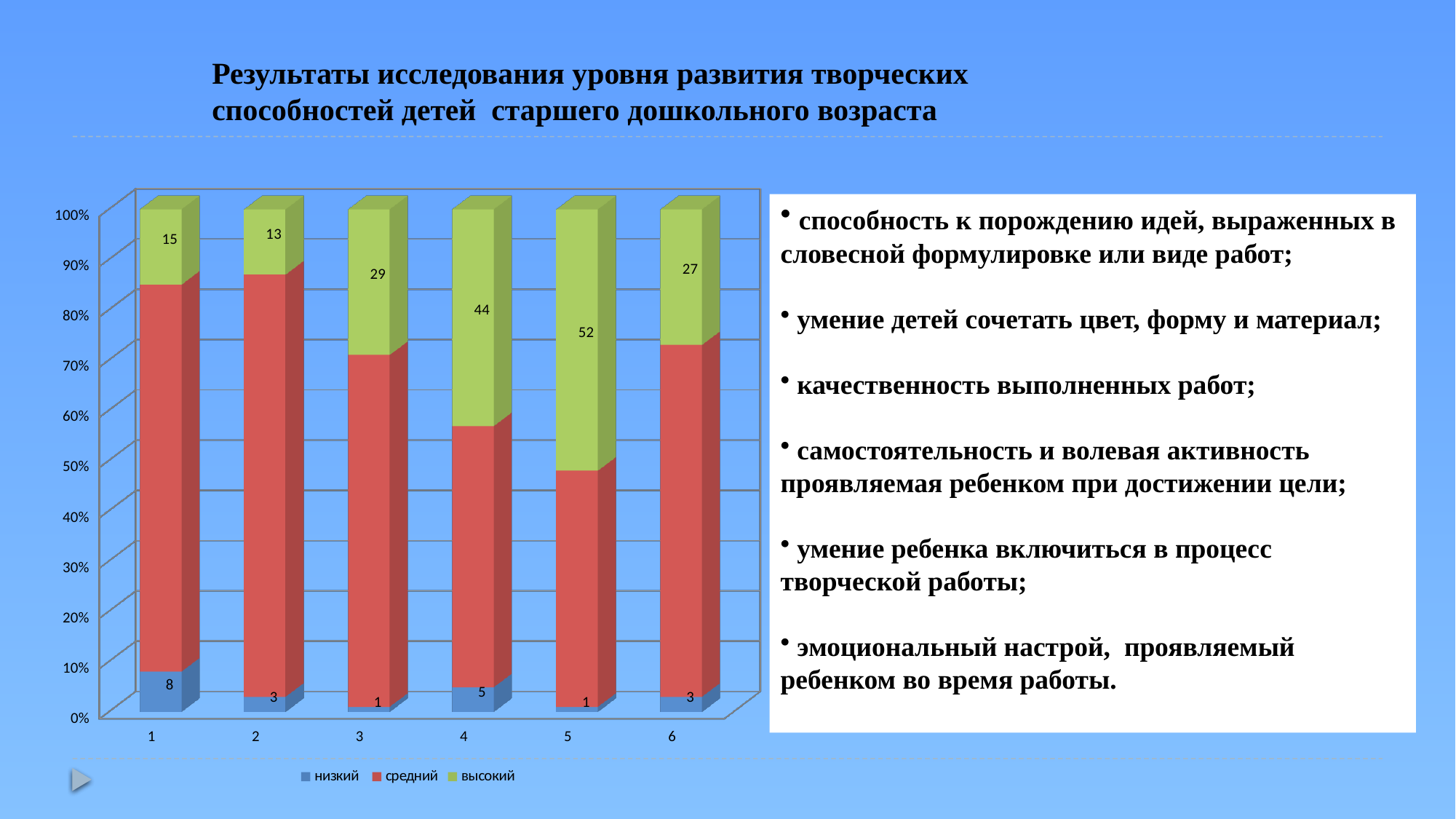
What is the value of the низкий series for category 4? 5 Which category has the lowest value for the высокий series? 2 What is the value of the высокий series for category 3? 29 What kind of chart is shown on the slide? stacked bar chart What is the value of the высокий series for category 5? 52 How many categories are shown on the x axis? 6 Which category has the highest value for the низкий series? 1 What is the value of the низкий series for category 1? 8 How many series does the legend list? 3 What is the difference between the высокий values for categories 5 and 4? 8 Which is larger, the высокий value for category 6 or for category 3? category 3 Which category has the highest value for the высокий series? 5